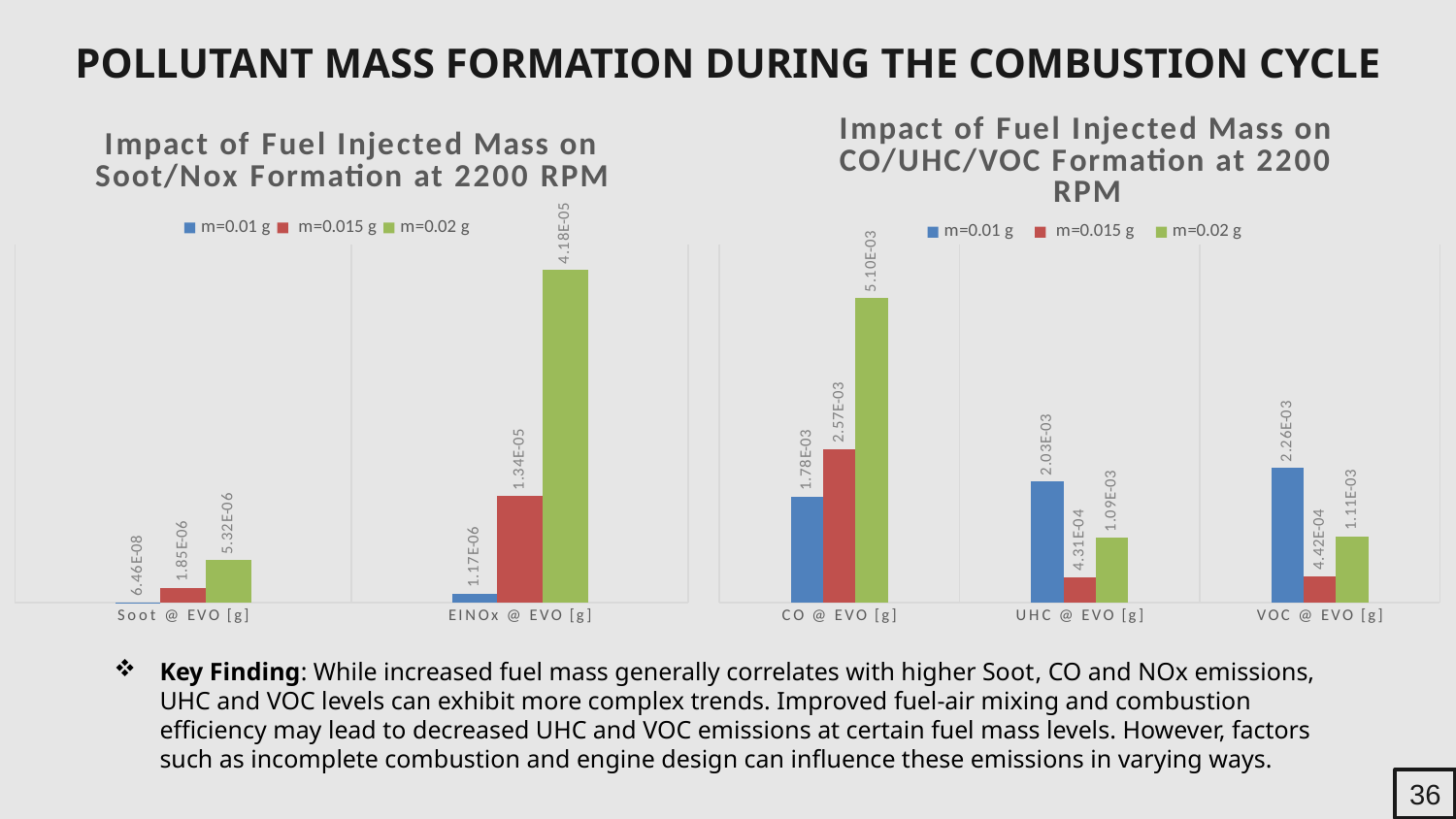
What kind of chart is the left chart (Soot/Nox Formation at 2200 RPM)? Bar chart In the right chart (CO/UHC/VOC Formation at 2200 RPM), what is the value for m=0.015 g at UHC @ EVO [g]? 4.31E-04 In the right chart (CO/UHC/VOC Formation at 2200 RPM), which series has the highest value at UHC @ EVO [g]? m=0.01 g In the right chart (CO/UHC/VOC Formation at 2200 RPM), what is the value for m=0.02 g at CO @ EVO [g]? 5.10E-03 In the left chart (Soot/Nox Formation at 2200 RPM), what is the value for m=0.015 g at EINOx @ EVO [g]? 1.34E-05 In the right chart (CO/UHC/VOC Formation at 2200 RPM), what is the value for m=0.01 g at VOC @ EVO [g]? 2.26E-03 In the right chart (CO/UHC/VOC Formation at 2200 RPM), which is larger at CO @ EVO [g]: m=0.015 g or m=0.02 g? m=0.02 g In the left chart (Soot/Nox Formation at 2200 RPM), what is the value for m=0.02 g at EINOx @ EVO [g]? 4.18E-05 How many categories are shown on the x axis of the right chart (CO/UHC/VOC Formation at 2200 RPM)? 3 In the right chart (CO/UHC/VOC Formation at 2200 RPM), which series has the lowest value at VOC @ EVO [g]? m=0.015 g In the left chart (Soot/Nox Formation at 2200 RPM), what is the value for m=0.01 g at Soot @ EVO [g]? 6.46E-08 How many series does the legend of the left chart (Soot/Nox Formation at 2200 RPM) list? 3